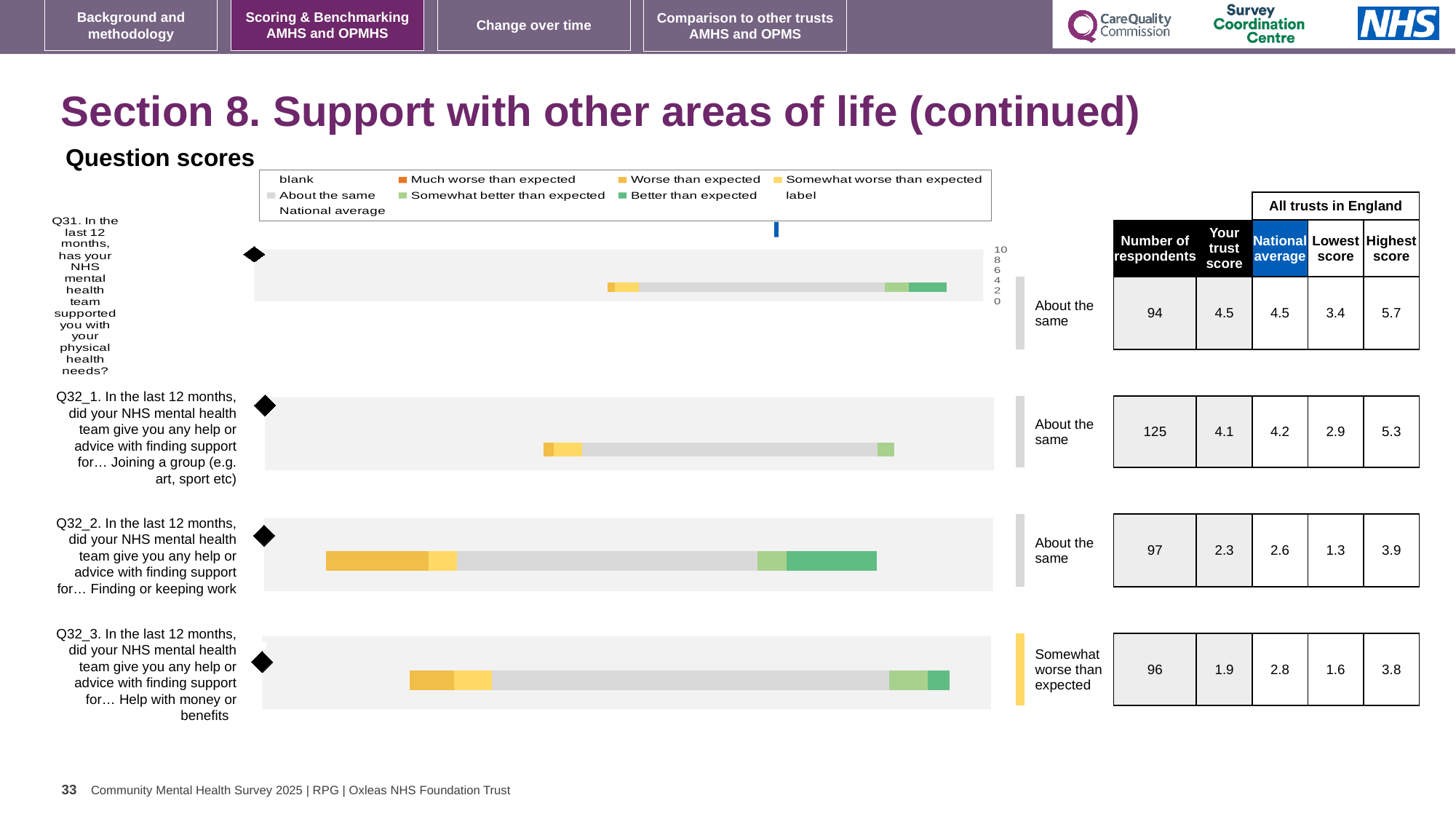
For Q32_3, what is the difference between the national average and the trust score? 0.9 How many questions (bars) are plotted in the question scores chart? 4 For Q32_2, which is larger: the trust score or the national average? National average How many respondents are shown for Q32_1 (help with joining a group)? 125 What kind of chart is used to show the question scores on this slide? Bar chart Which question is rated 'Somewhat worse than expected'? Q32_3 (help with money or benefits) In the legend, which colour represents 'Much worse than expected'? Orange What is the 'Your trust score' for Q31 (support with physical health needs)? 4.5 What is the highest score among all trusts in England for Q32_2 (finding or keeping work)? 3.9 What is the national average for Q32_3 (help with money or benefits)? 2.8 Which question has the highest 'Your trust score'? Q31 (support with physical health needs) Which question has the lowest 'Your trust score'? Q32_3 (help with money or benefits)